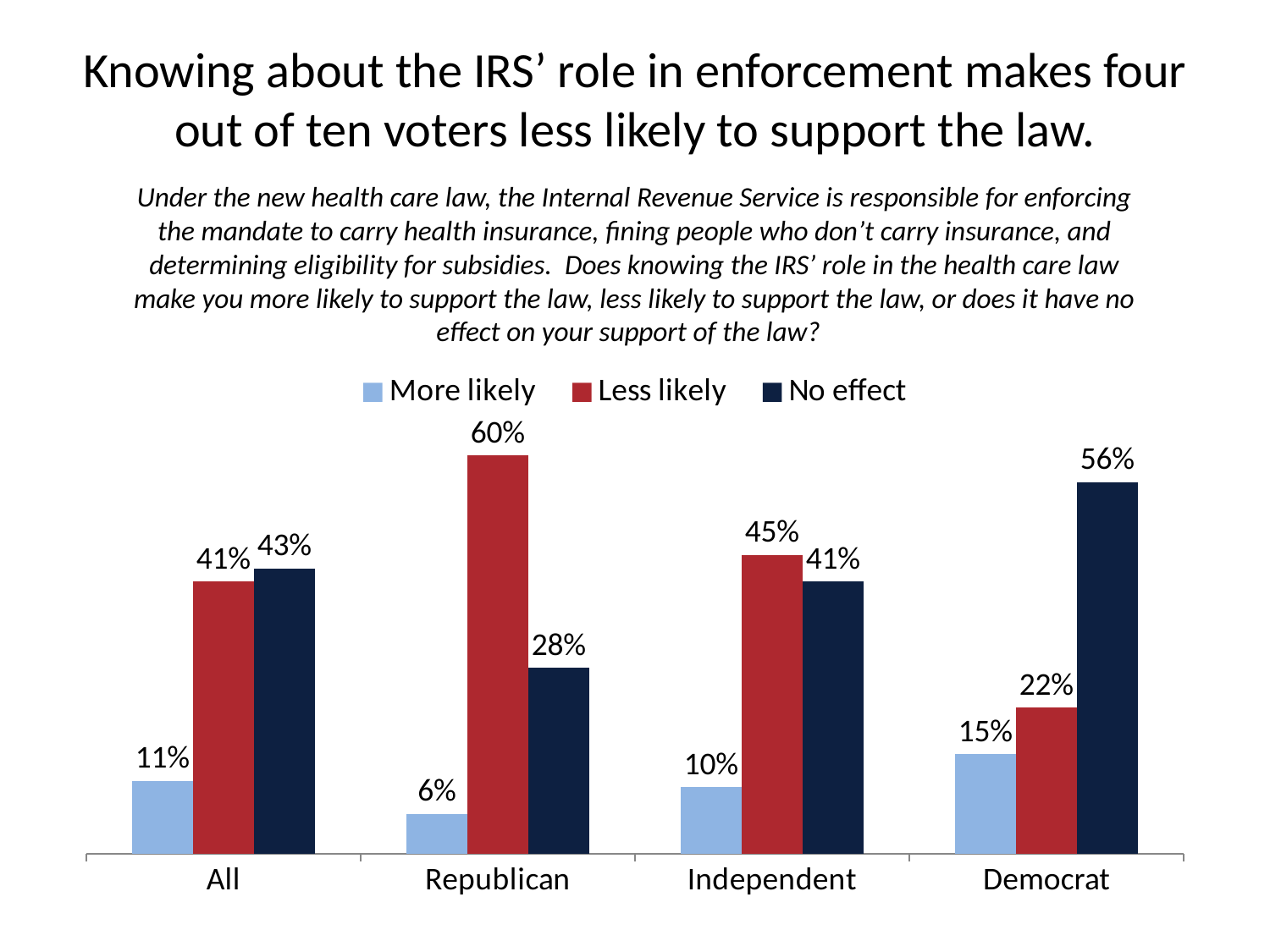
Which group has the highest 'Less likely' value? Republican What is the 'No effect' value for Democrats? 56% For Independents, which is larger: 'Less likely' or 'No effect'? Less likely What kind of chart is shown on the slide? Bar chart What is the 'More likely' value for All voters? 11% Which colour represents the 'Less likely' series? Red Which group has the lowest 'More likely' value? Republican What is the difference between the 'No effect' values for Democrats and Republicans? 28% How many series does the legend list? 3 What percentage of Republicans say knowing the IRS' role makes them less likely to support the law? 60% What is the difference between the 'Less likely' values for Republicans and Democrats? 38% How many groups are shown on the x axis? 4